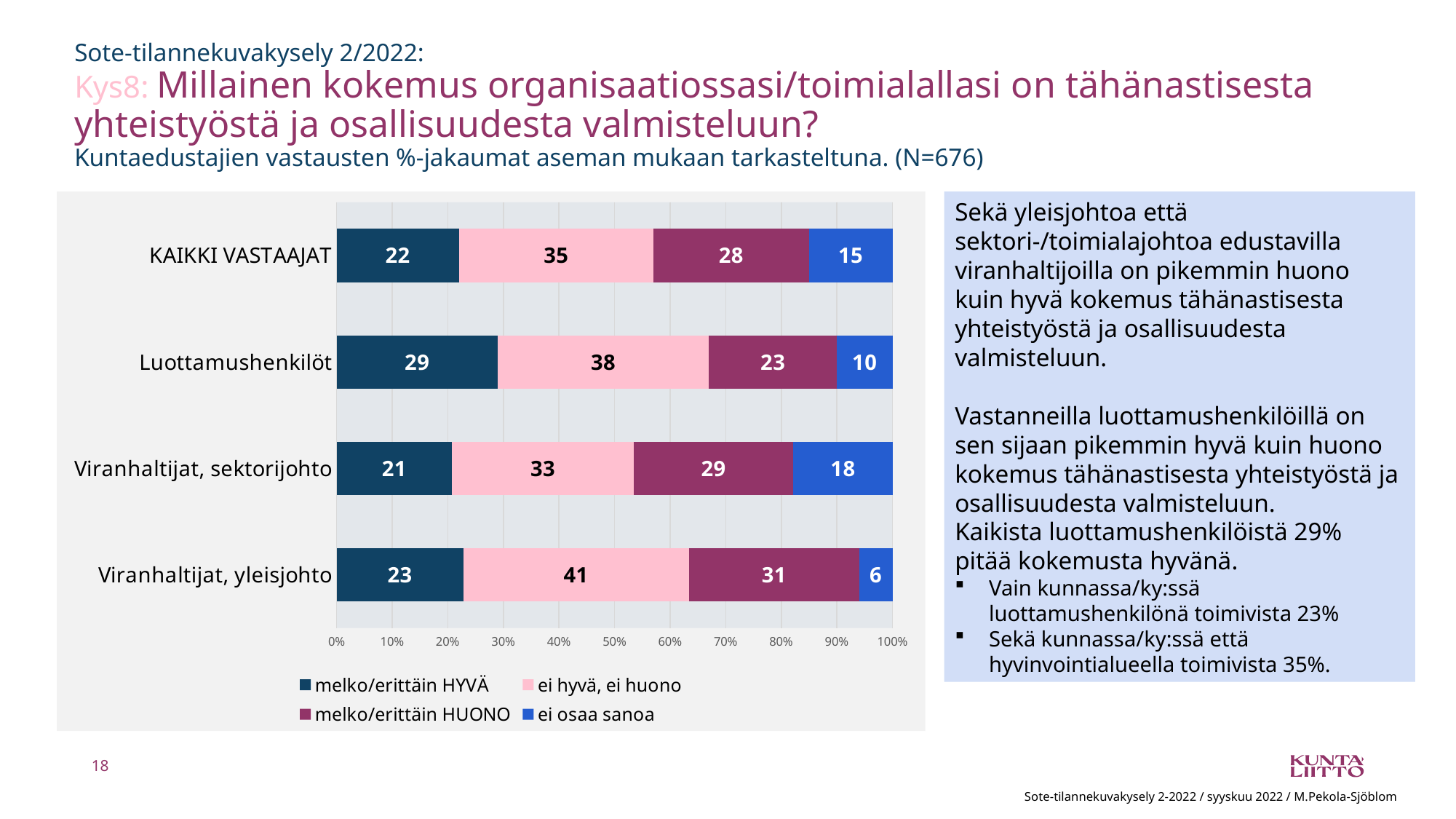
What is the value of 'melko/erittäin HUONO' for KAIKKI VASTAAJAT? 28 What is the value of 'ei hyvä, ei huono' for Viranhaltijat, sektorijohto? 33 Which category has the lowest value for 'ei osaa sanoa'? Viranhaltijat, yleisjohto What kind of chart is shown on the slide? stacked bar chart What is the value of 'ei osaa sanoa' for Viranhaltijat, yleisjohto? 6 How many categories (respondent groups) are shown on the chart? 4 How many series does the chart legend list? 4 Which is larger for Viranhaltijat, sektorijohto: 'melko/erittäin HYVÄ' or 'melko/erittäin HUONO'? melko/erittäin HUONO Which category has the highest value for 'ei hyvä, ei huono'? Viranhaltijat, yleisjohto Which series is shown in pink in the chart legend? ei hyvä, ei huono What is the value of 'melko/erittäin HYVÄ' for Luottamushenkilöt? 29 What is the difference between the 'melko/erittäin HUONO' values for Viranhaltijat, yleisjohto and Luottamushenkilöt? 8